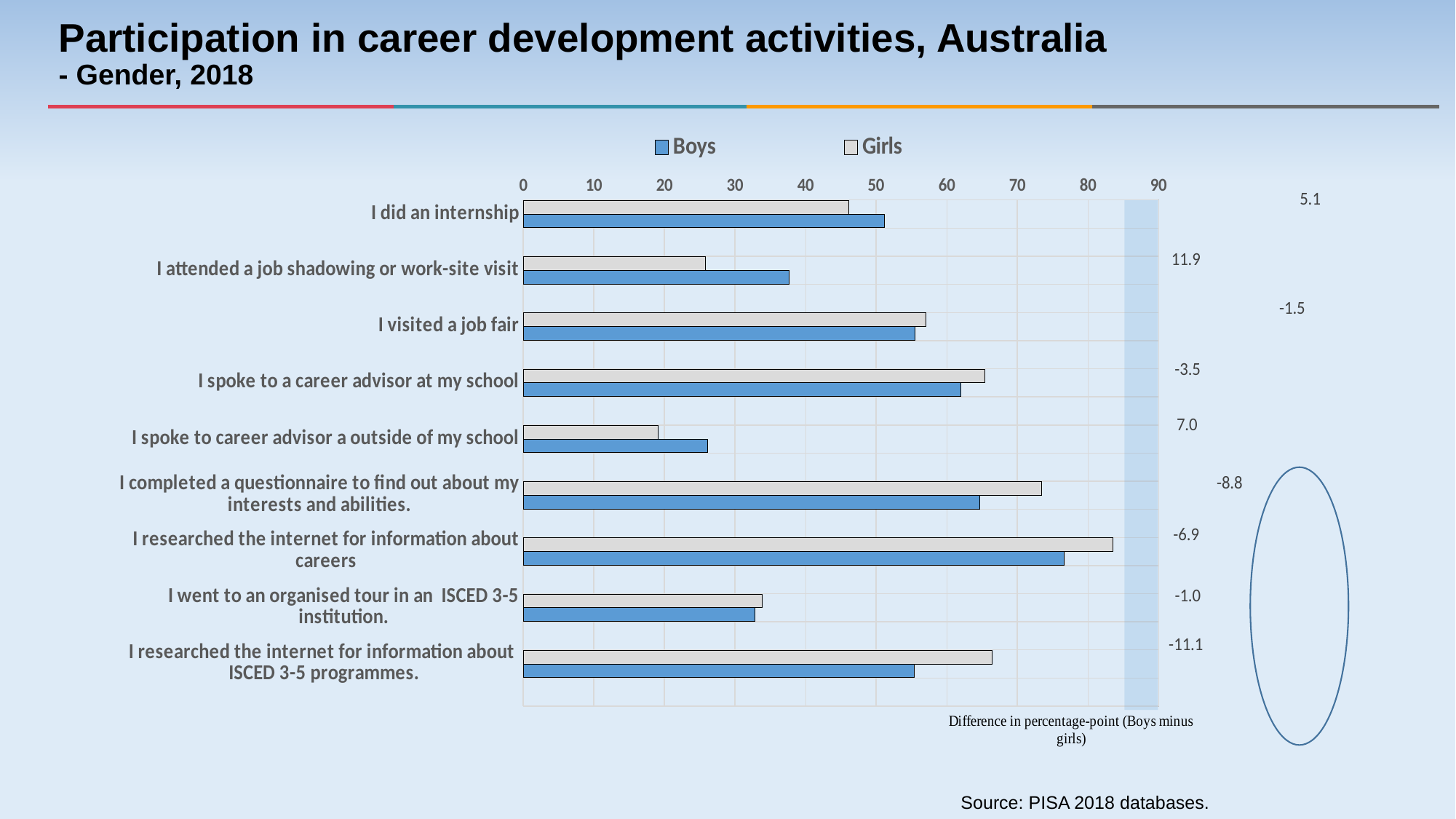
Which activity has the highest Girls value? I researched the internet for information about careers Is the Girls value for 'I researched the internet for information about careers' greater or less than 80? greater Which series are listed in the legend? Boys and Girls Is the Boys value for 'I attended a job shadowing or work-site visit' greater or less than 30? greater How many activity categories are plotted on the chart? 9 What is the printed difference in percentage-point (Boys minus girls) for 'I attended a job shadowing or work-site visit'? 11.9 For 'I completed a questionnaire to find out about my interests and abilities.', which is larger, the Boys value or the Girls value? Girls For 'I attended a job shadowing or work-site visit', which is larger, the Boys value or the Girls value? Boys What kind of chart is shown on the slide? bar chart Which activity has the lowest Boys value? I spoke to career advisor a outside of my school How many series does the legend list? 2